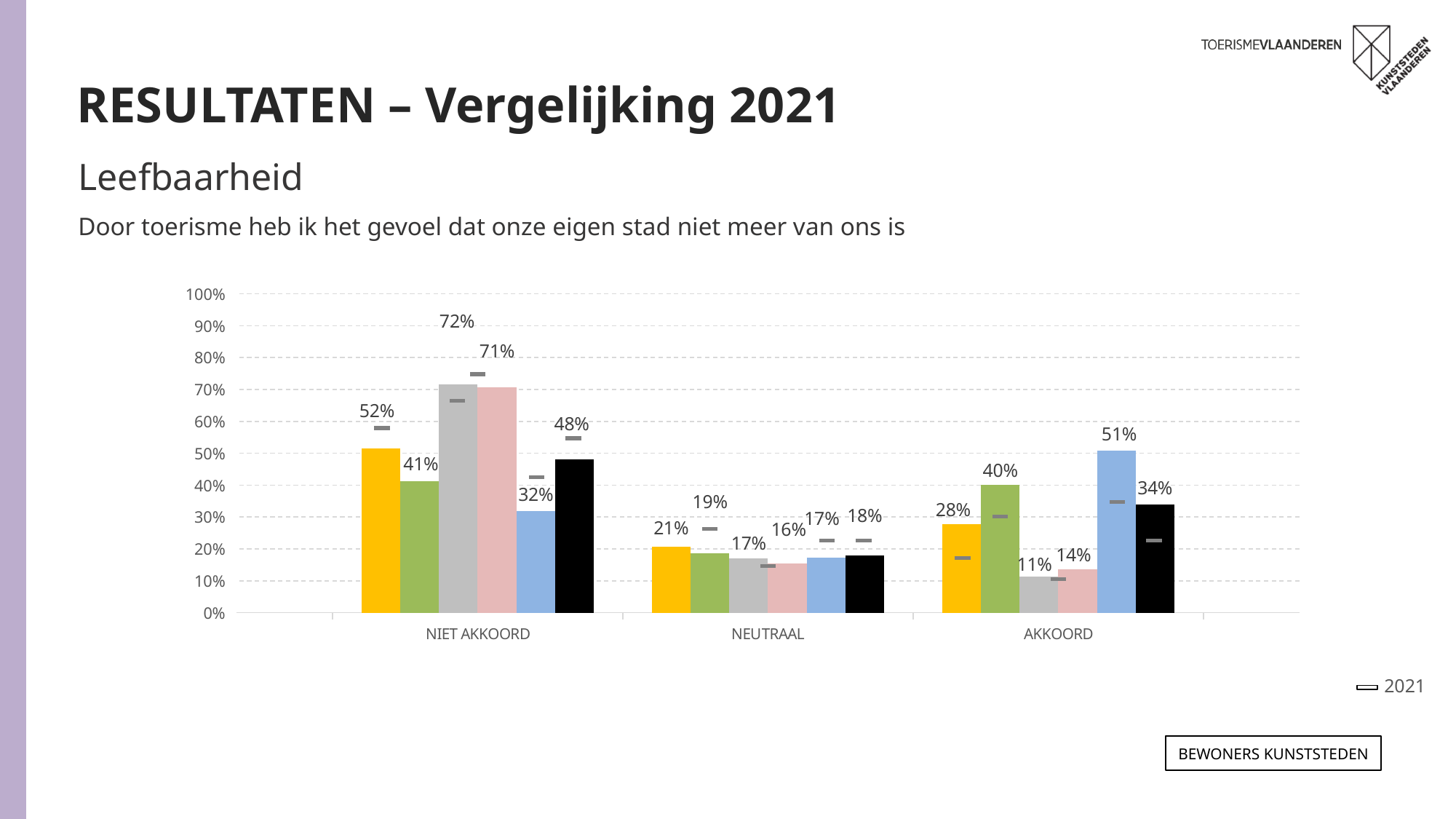
What is the value of the blue bar for AKKOORD? 51% What is the value of the black bar for NEUTRAAL? 18% Which bar is the highest in the NIET AKKOORD category? the grey bar (72%) What is the difference between the yellow bar and the pink bar for AKKOORD? 14% What is the value of the yellow bar for NIET AKKOORD? 52% How many categories are shown on the x axis of the chart? 3 Which bar is the lowest in the AKKOORD category? the grey bar (11%) Which is larger for AKKOORD: the green bar or the black bar? the green bar (40%) Is the value of the pink bar for NIET AKKOORD greater or less than 60%? greater What type of chart is shown on the slide? bar chart What is the difference between the grey bar and the blue bar for NIET AKKOORD? 40% What year does the legend marker at the bottom right of the chart refer to? 2021